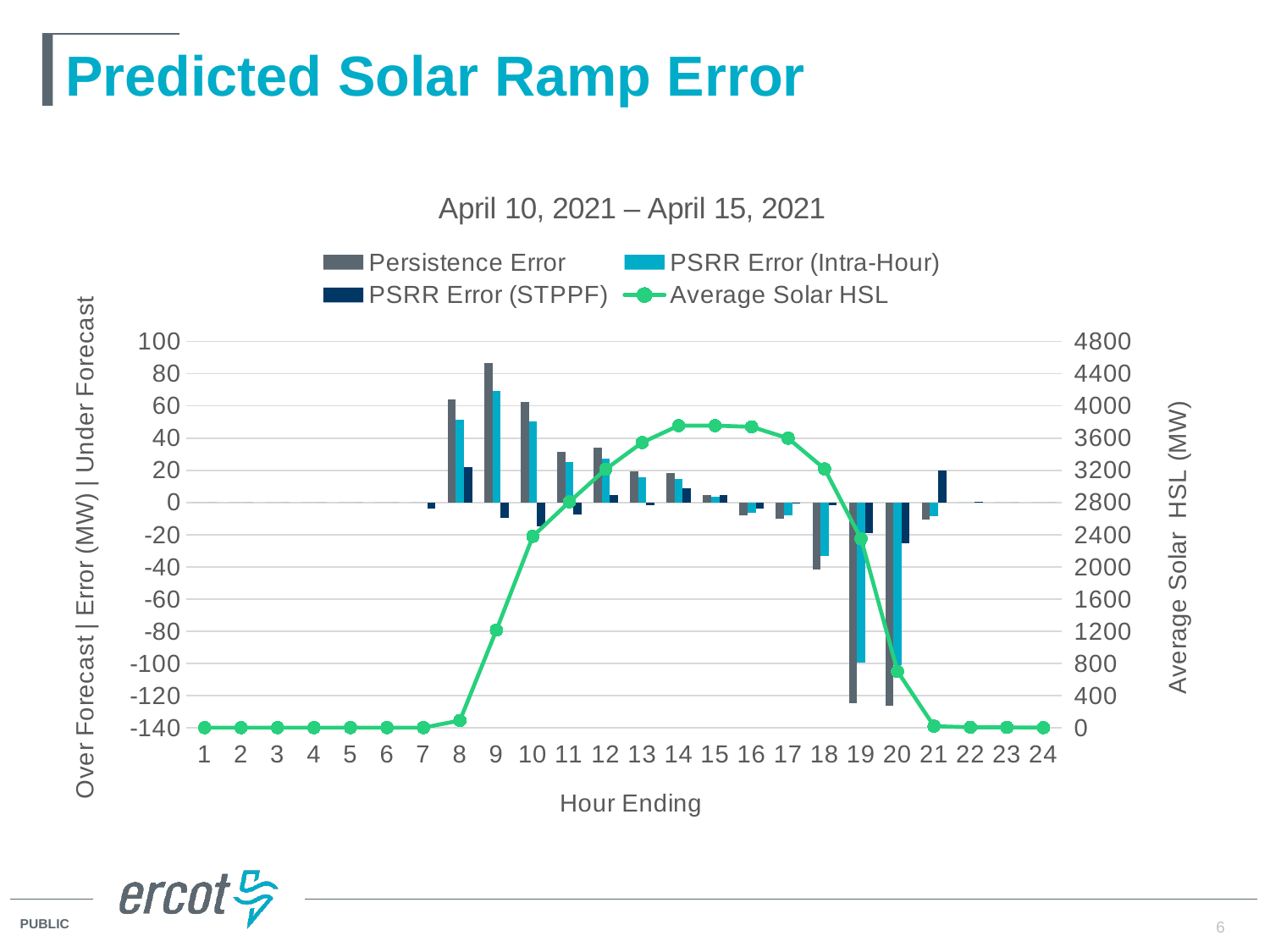
Does the Average Solar HSL rise or fall from hour ending 8 to hour ending 14? Rise How many series does the legend list? 4 At which hour ending is the Persistence Error highest? 9 Is the PSRR Error (Intra-Hour) at hour ending 19 greater or less than -80? less At which hour ending is the PSRR Error (Intra-Hour) highest? 9 What kind of chart is shown on the slide? Combination bar and line chart What is the title of the right-hand vertical axis? Average Solar HSL (MW) How many hours are shown along the x axis? 24 Which is larger, the Persistence Error at hour ending 8 or at hour ending 9? Hour ending 9 Is the Average Solar HSL at hour ending 9 greater or less than 1600? less Is the Persistence Error at hour ending 9 greater or less than 60? greater